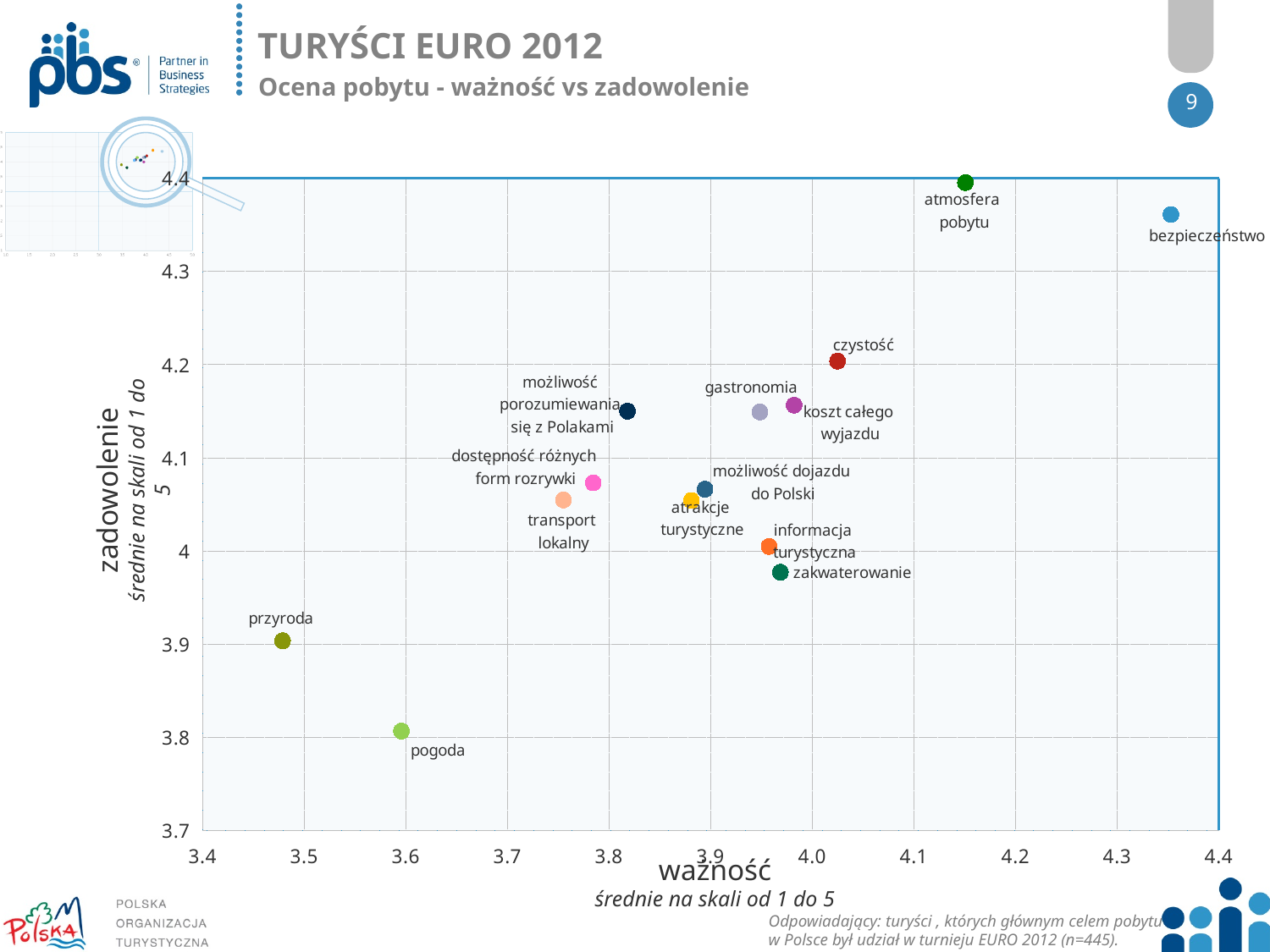
Which category has the lowest ważność (importance) value? przyroda Is the ważność value for bezpieczeństwo greater or less than 4.3? greater Which category has the highest zadowolenie (satisfaction) value? atmosfera pobytu What is the title of the horizontal axis? ważność Which category has the lowest zadowolenie (satisfaction) value? pogoda Which has the higher zadowolenie value, czystość or pogoda? czystość How many data points are plotted on the chart? 14 Is the zadowolenie value for przyroda greater or less than 4? less Which category has the highest ważność (importance) value? bezpieczeństwo Is the ważność value for pogoda greater or less than 3.7? less What kind of chart is shown on the slide? scatter chart Which has the higher ważność value, atmosfera pobytu or przyroda? atmosfera pobytu